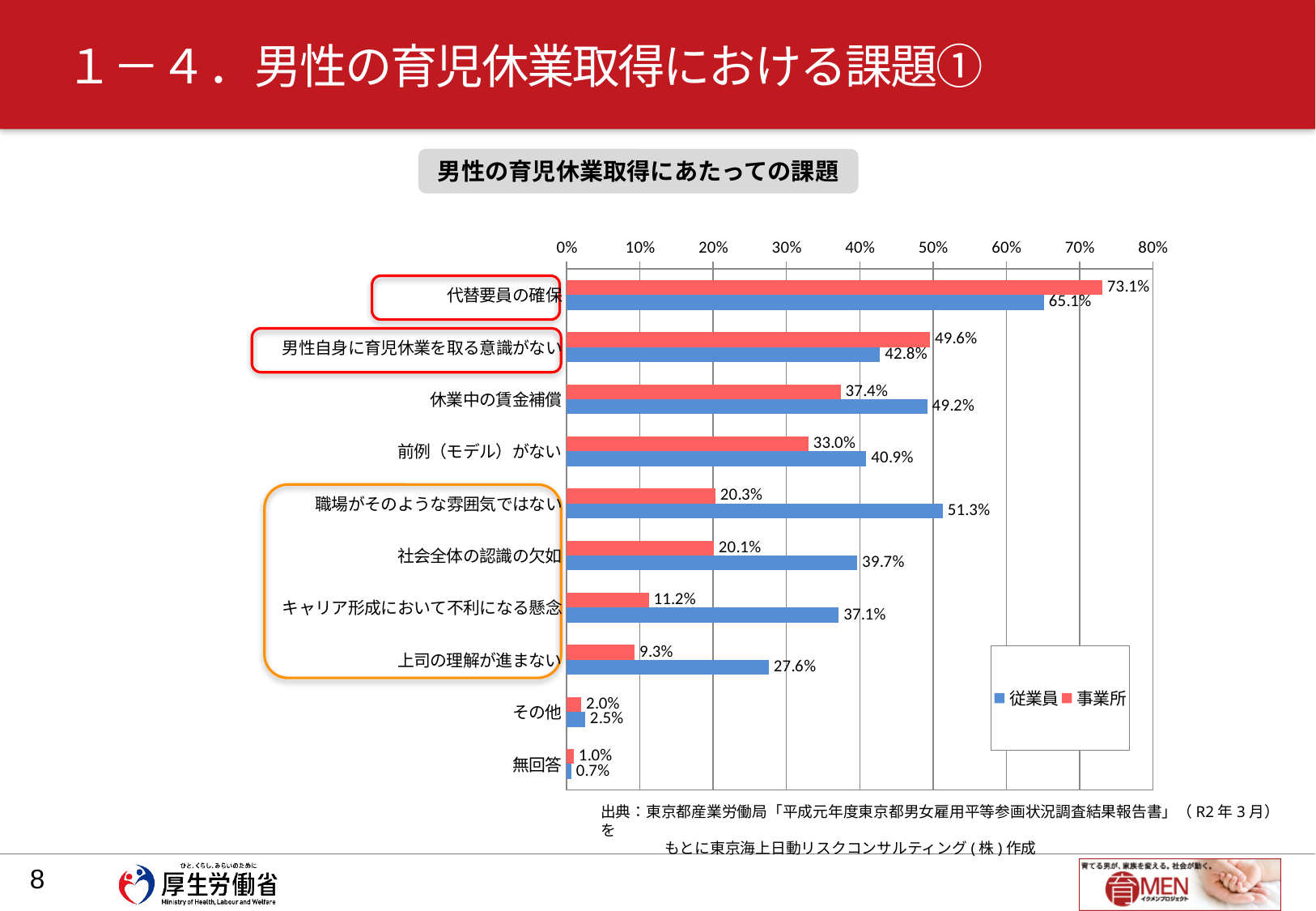
How many series does the legend list? 2 What type of chart is shown on the slide? bar chart What is the 事業所 value for 代替要員の確保? 73.1% Which colour represents the 事業所 series? red How many categories are plotted on the chart? 10 Which category has the lowest 従業員 value? 無回答 What is the difference between the 従業員 and 事業所 values for 職場がそのような雰囲気ではない? 31.0% Is the 事業所 value for キャリア形成において不利になる懸念 greater or less than 20%? less Which category has the highest 事業所 value? 代替要員の確保 What is the 従業員 value for 職場がそのような雰囲気ではない? 51.3% For 休業中の賃金補償, which is larger: the 従業員 value or the 事業所 value? 従業員 What is the 従業員 value for 上司の理解が進まない? 27.6%